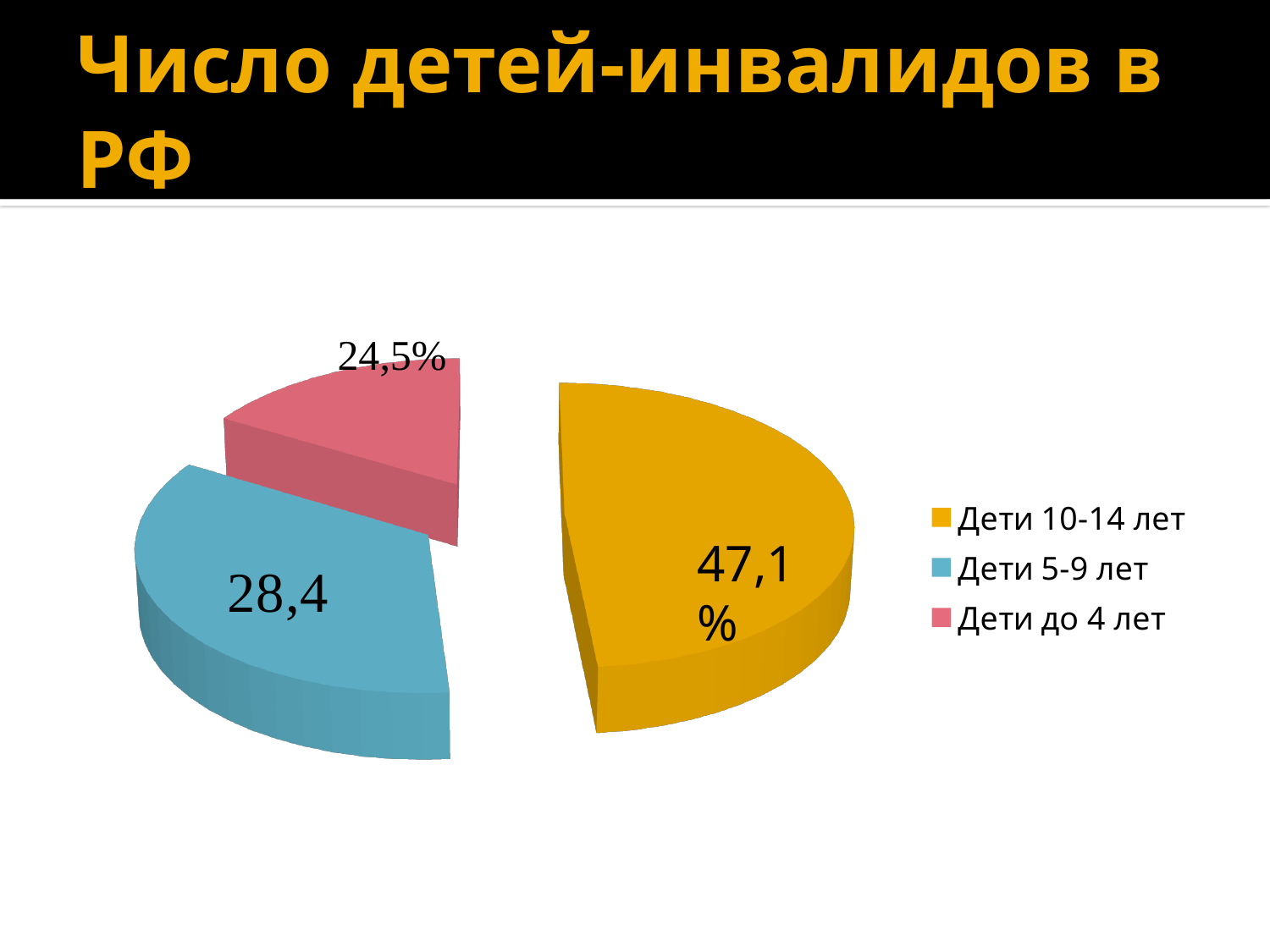
What is the difference between the shares for Дети 10-14 лет and Дети до 4 лет? 22,6% What is the title of the chart on the slide? Число детей-инвалидов в РФ What share of the pie is labelled for Дети до 4 лет? 24,5% What type of chart is shown on the slide? pie chart Which category has the largest slice of the pie? Дети 10-14 лет Which is larger, the slice for Дети 5-9 лет or the slice for Дети до 4 лет? Дети 5-9 лет What value is printed on the slice for Дети 5-9 лет? 28,4 What colour is the slice for Дети 5-9 лет? blue How many slices does the pie chart have? 3 How many entries does the legend list? 3 What share of the pie is labelled for Дети 10-14 лет? 47,1% Which category has the smallest slice of the pie? Дети до 4 лет